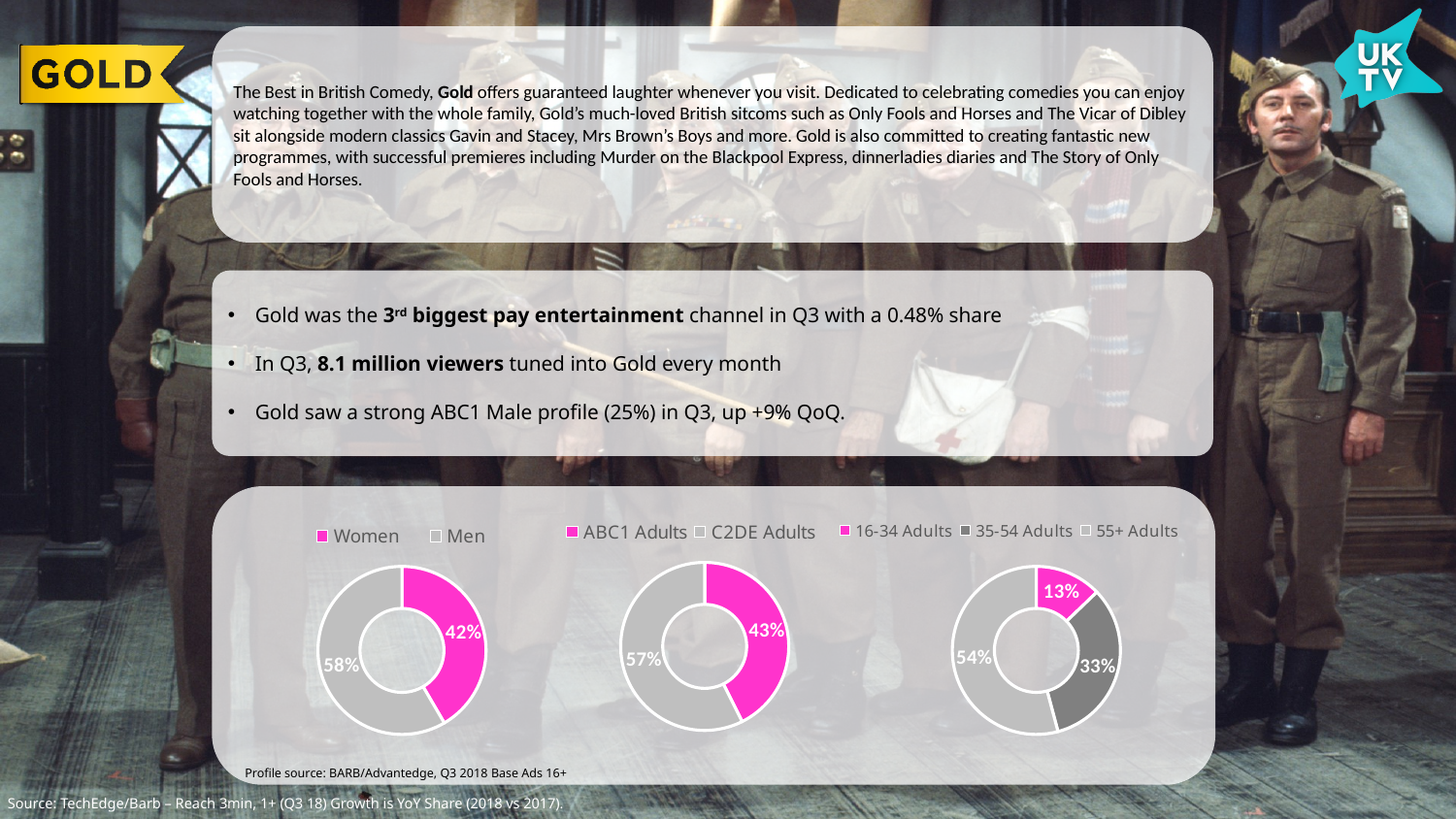
In the left donut chart, what is the difference between the Men and Women shares? 16% How many series does the legend of the right donut chart list? 3 In the right donut chart, what share is shown for 16-34 Adults? 13% In the middle donut chart, what share is shown for C2DE Adults? 57% In the left donut chart, what share is shown for Men? 58% In the right donut chart, which age group has the smallest share? 16-34 Adults In the middle donut chart, which is larger, ABC1 Adults or C2DE Adults? C2DE Adults In the right donut chart, what share is shown for 35-54 Adults? 33% In the left donut chart, what share is shown for Women? 42% In the middle donut chart, what share is shown for ABC1 Adults? 43% What kind of chart is used for the three charts at the bottom of the slide? Donut (pie) chart In the right donut chart, which age group has the largest share? 55+ Adults